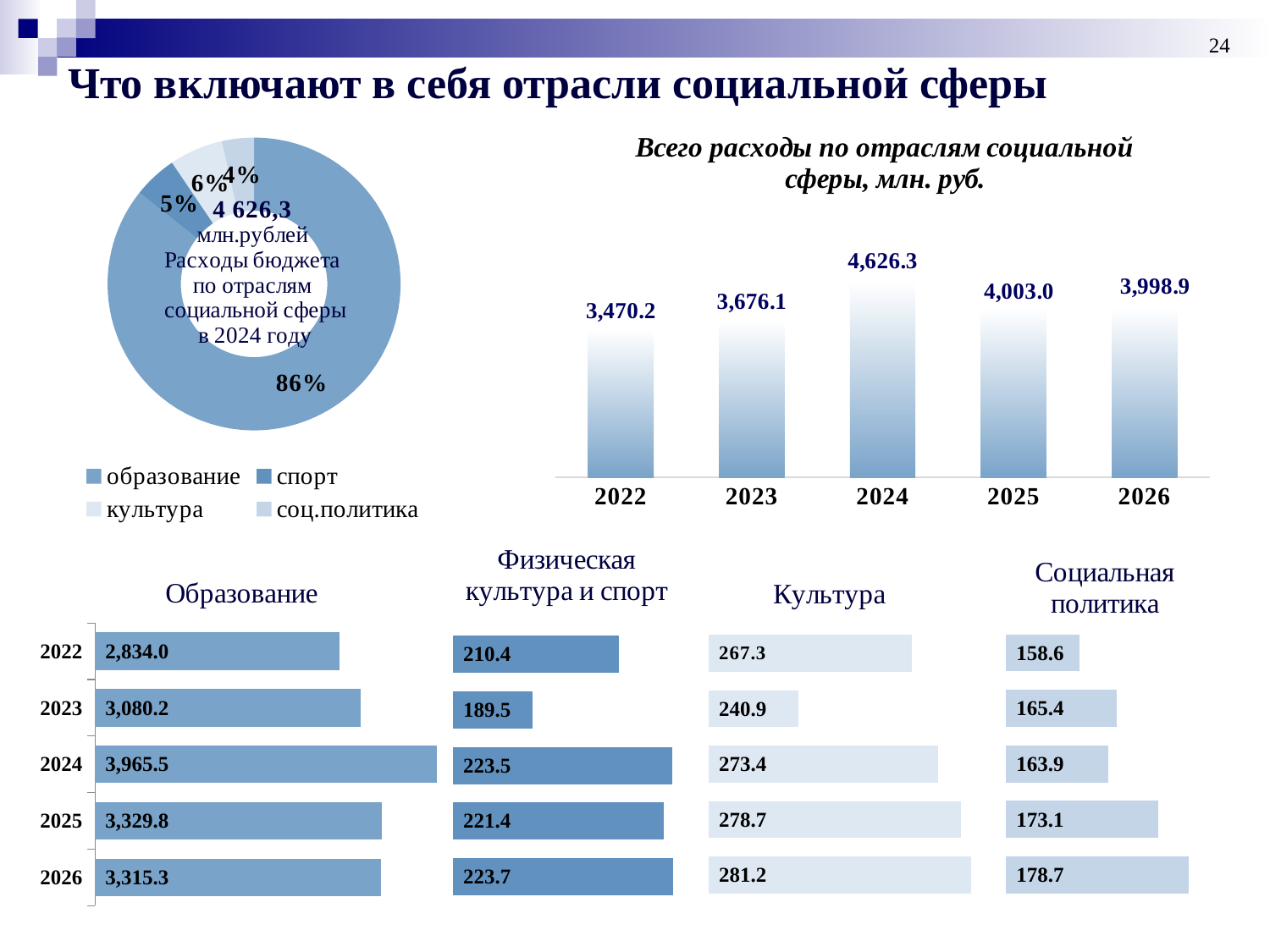
In the chart 'Всего расходы по отраслям социальной сферы, млн. руб.', what is the value for 2024? 4,626.3 In the chart 'Всего расходы по отраслям социальной сферы, млн. руб.', which year has the lowest value? 2022 In the chart 'Всего расходы по отраслям социальной сферы, млн. руб.', how many years are shown? 5 In the chart 'Всего расходы по отраслям социальной сферы, млн. руб.', which year has the highest value? 2024 In the 'Физическая культура и спорт' chart, which is larger, the value for 2022 or for 2023? 2022 In the 'Социальная политика' chart, which year has the lowest value? 2022 In the 'Образование' chart, what is the value for 2024? 3,965.5 In the 'Культура' chart, do the values rise or fall from 2023 to 2026? rise What kind of chart is 'Всего расходы по отраслям социальной сферы, млн. руб.'? bar chart In the chart 'Всего расходы по отраслям социальной сферы, млн. руб.', what is the difference between the 2024 and 2023 values? 950.2 How many entries does the legend of the donut chart on the top left list? 4 In the donut chart on the top left, what share does 'образование' have? 86%